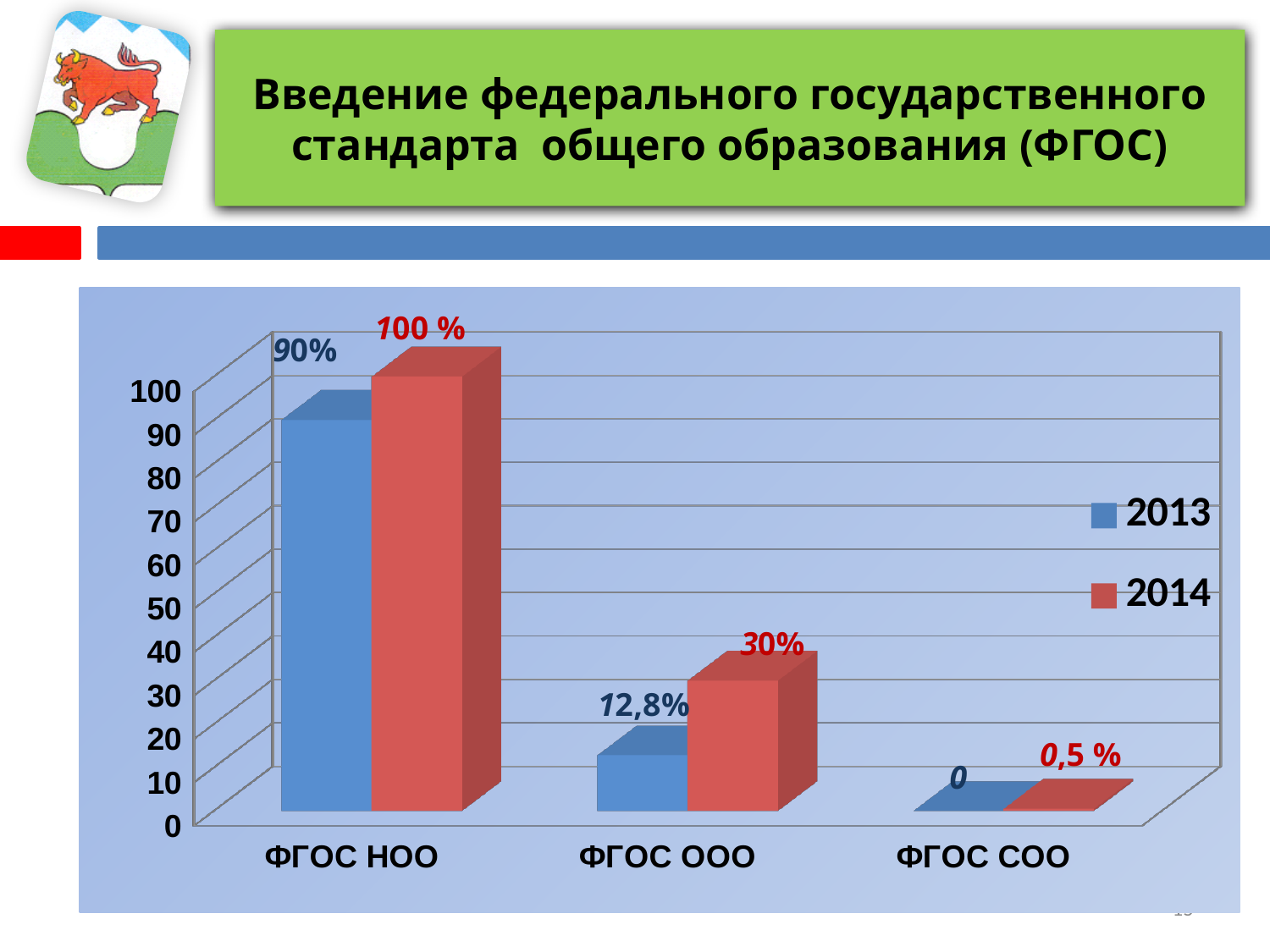
What is the value for ФГОС ООО in 2013? 12,8% How many series does the legend list? 2 What is the value for ФГОС СОО in 2014? 0,5 % What is the value for ФГОС НОО in 2013? 90% Which colour represents the 2014 series in the legend? Red What kind of chart is shown on the slide? Bar chart What is the value for ФГОС ООО in 2014? 30% Which category has the lowest value in 2013? ФГОС СОО What is the value for ФГОС НОО in 2014? 100 % Which is larger for ФГОС ООО: the 2013 value or the 2014 value? 2014 How many categories are shown on the x axis? 3 Which category has the highest value in 2014? ФГОС НОО